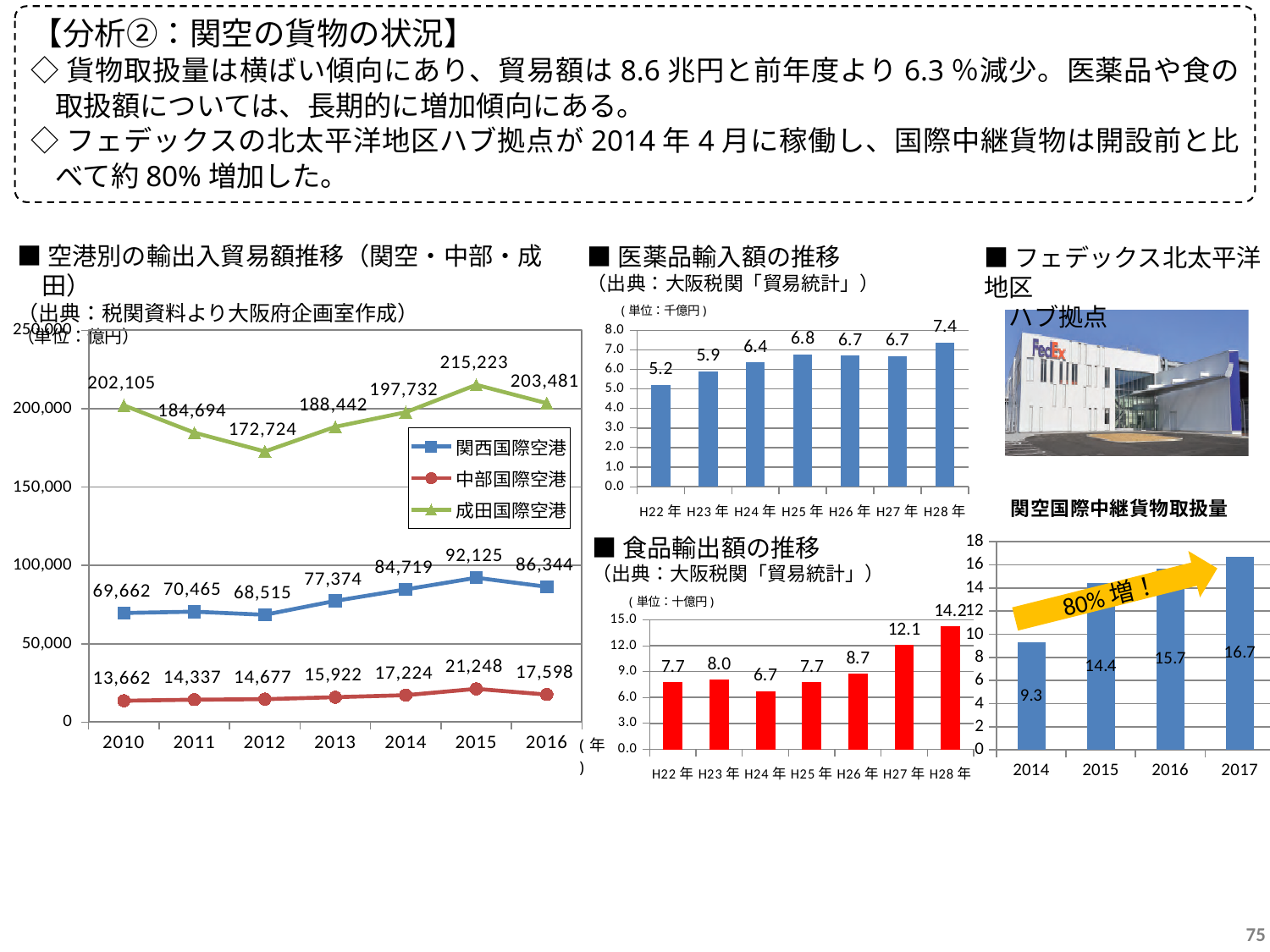
In the food exports chart (食品輸出額の推移), what is the value for H27年? 12.1 In the food exports chart (食品輸出額の推移), how many years are plotted? 7 What kind of chart is the 関空国際中継貨物取扱量 chart? Bar chart In the line chart of import/export trade by airport, what is the difference between the 関西国際空港 values for 2016 and 2015? 5,781 In the food exports chart (食品輸出額の推移), which is larger, the value for H23年 or H24年? H23年 In the line chart of import/export trade by airport, what is the value for 成田国際空港 in 2012? 172,724 In the pharmaceutical imports chart (医薬品輸入額の推移), which year has the lowest value? H22年 In the 関空国際中継貨物取扱量 chart, what is the value for 2014? 9.3 In the line chart of import/export trade by airport, in which year is the 中部国際空港 value highest? 2015 In the line chart of import/export trade by airport (空港別の輸出入貿易額推移), what is the value for 関西国際空港 in 2015? 92,125 In the pharmaceutical imports chart (医薬品輸入額の推移), what is the value for H28年? 7.4 In the line chart of import/export trade by airport, how many series does the legend list? 3